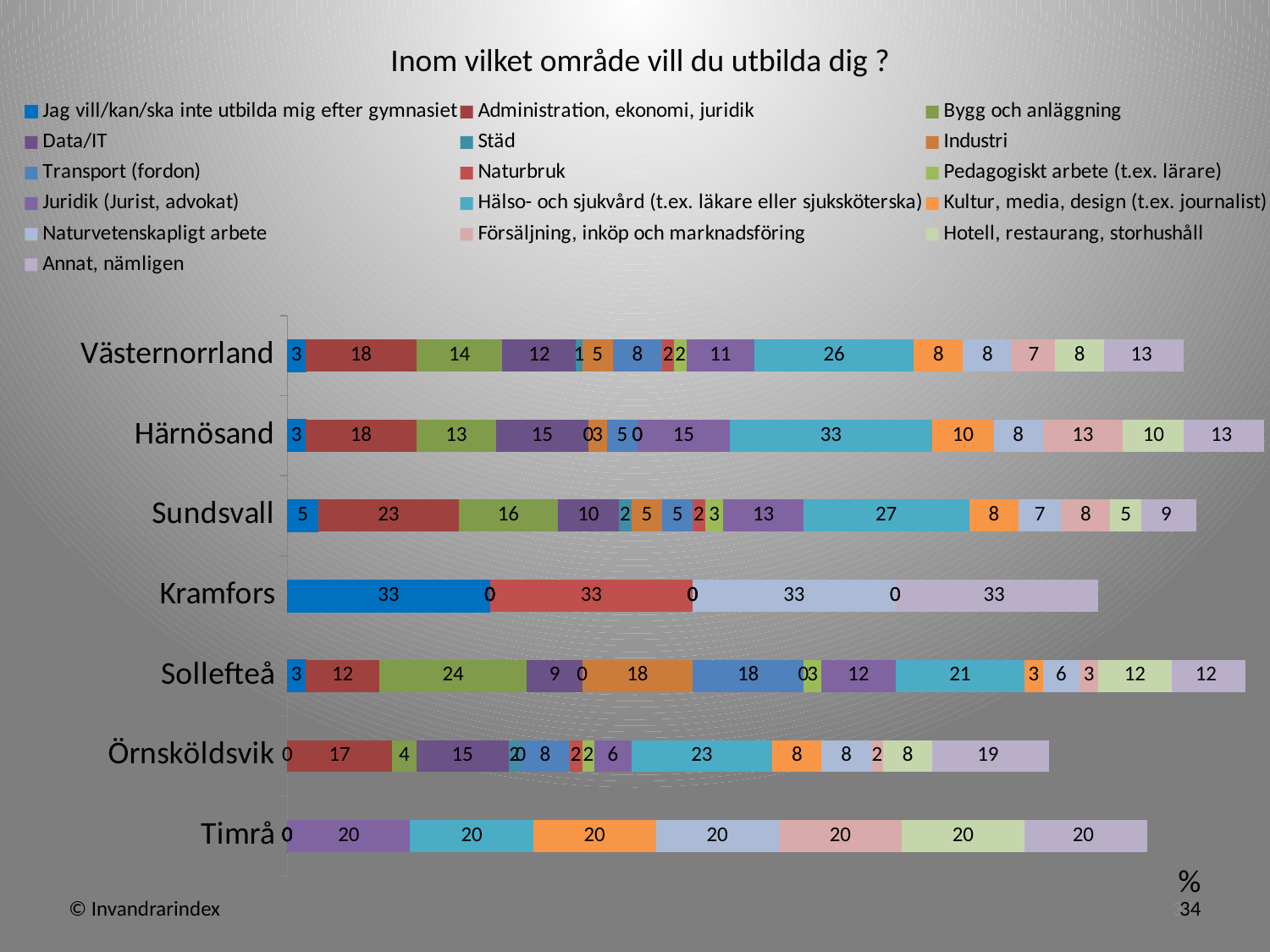
What is the title of the chart? Inom vilket område vill du utbilda dig ? How many regions/municipalities are shown on the y axis of the chart? 7 What value is shown for each of the seven segments in the Timrå bar? 20 What is the difference between the Hälso- och sjukvård value for Härnösand and for Sundsvall? 6 What is the value for Bygg och anläggning for Sollefteå? 24 What type of chart is shown on the slide? stacked bar chart What is the value for Administration, ekonomi, juridik for Sundsvall? 23 What is the value for Annat, nämligen for Örnsköldsvik? 19 Which region has the highest value for Hälso- och sjukvård (t.ex. läkare eller sjuksköterska)? Härnösand What is the value for Hälso- och sjukvård (t.ex. läkare eller sjuksköterska) for Västernorrland? 26 How many series does the legend list? 16 Which is larger: the Administration, ekonomi, juridik value for Sundsvall or for Härnösand? Sundsvall